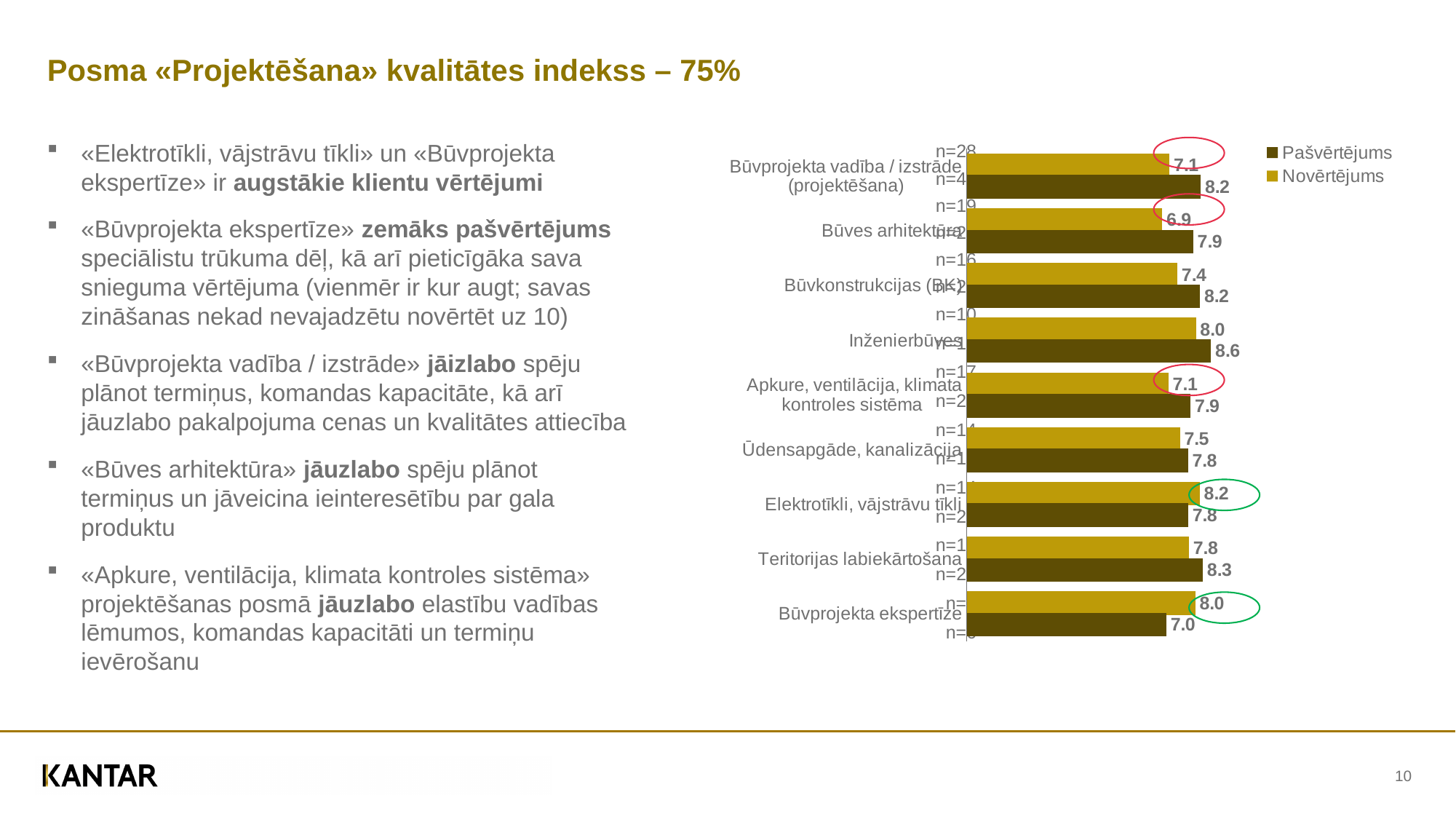
What is the Novērtējums value for Elektrotīkli, vājstrāvu tīkli? 8.2 What is the Novērtējums value for Būves arhitektūra? 6.9 What is the Pašvērtējums value for Būvprojekta ekspertīze? 7.0 For Būvprojekta ekspertīze, which is larger: Pašvērtējums or Novērtējums? Novērtējums What kind of chart is shown on the slide? Bar chart What is the difference between the Pašvērtējums and Novērtējums values for Būvprojekta vadība / izstrāde (projektēšana)? 1.1 What is the Pašvērtējums value for Inženierbūves? 8.6 How many categories are shown in the chart? 9 How many series does the legend list? 2 Which series is shown in the darker colour in the legend? Pašvērtējums Which category has the highest Pašvērtējums value? Inženierbūves Which category has the lowest Novērtējums value? Būves arhitektūra